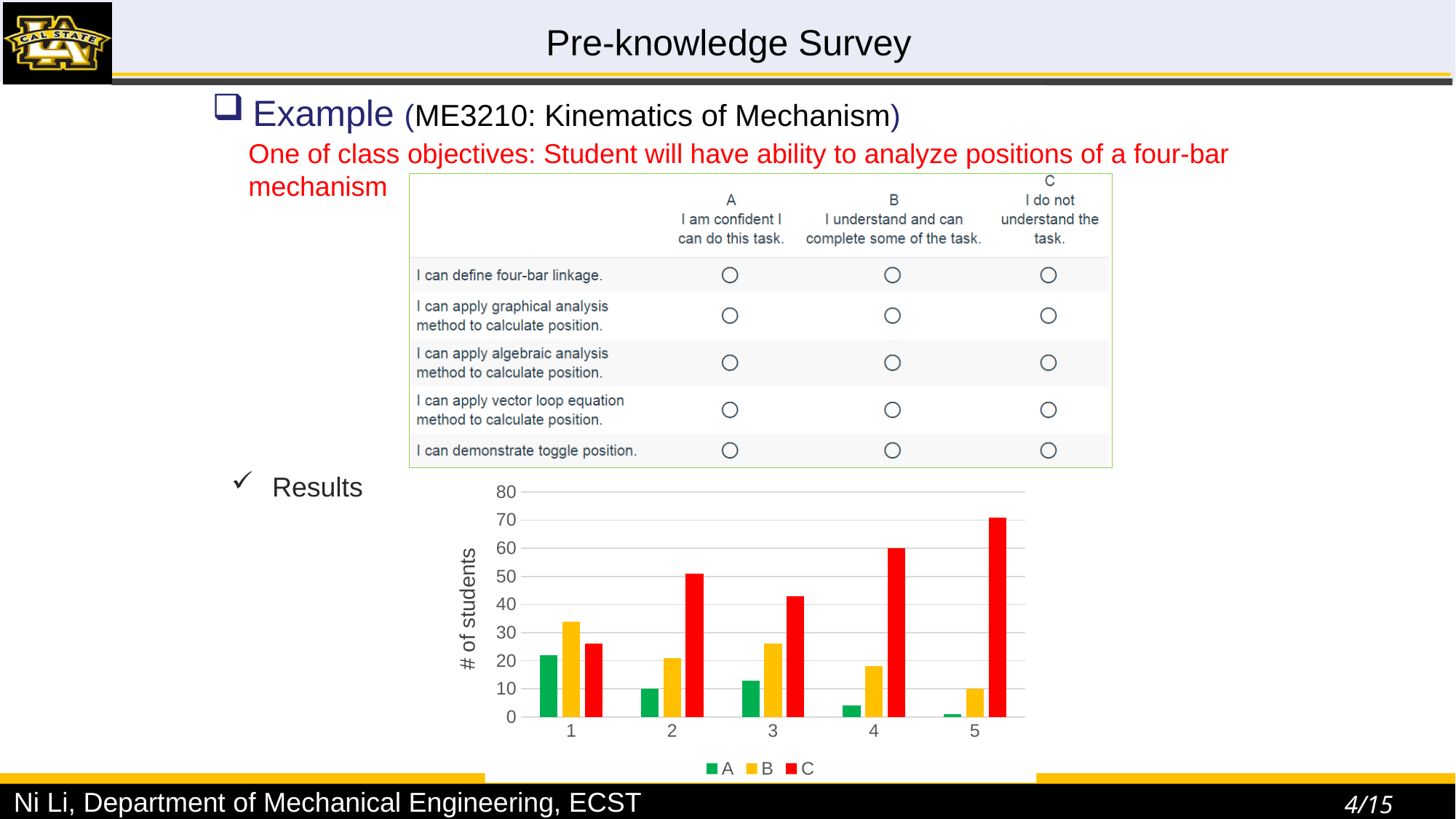
How many categories are shown on the x axis of the Results chart? 5 How many series does the legend of the Results chart list? 3 In the Results chart, is the value for series A at category 4 greater or less than 10? less In the Results chart, is the value for series C at category 5 greater or less than 60? greater In the Results chart, does series A generally rise or fall from category 1 to category 5? fall What is the y-axis label of the Results chart? # of students In the Results chart, for category 4, which is larger: series B or series C? C In the Results chart, which category has the lowest value for series A? 5 What kind of chart is shown under "Results"? bar chart In the Results chart, for category 1, which is larger: series A or series B? B In the Results chart, is the value for series C at category 2 greater or less than 40? greater In the Results chart, which category has the highest value for series C? 5